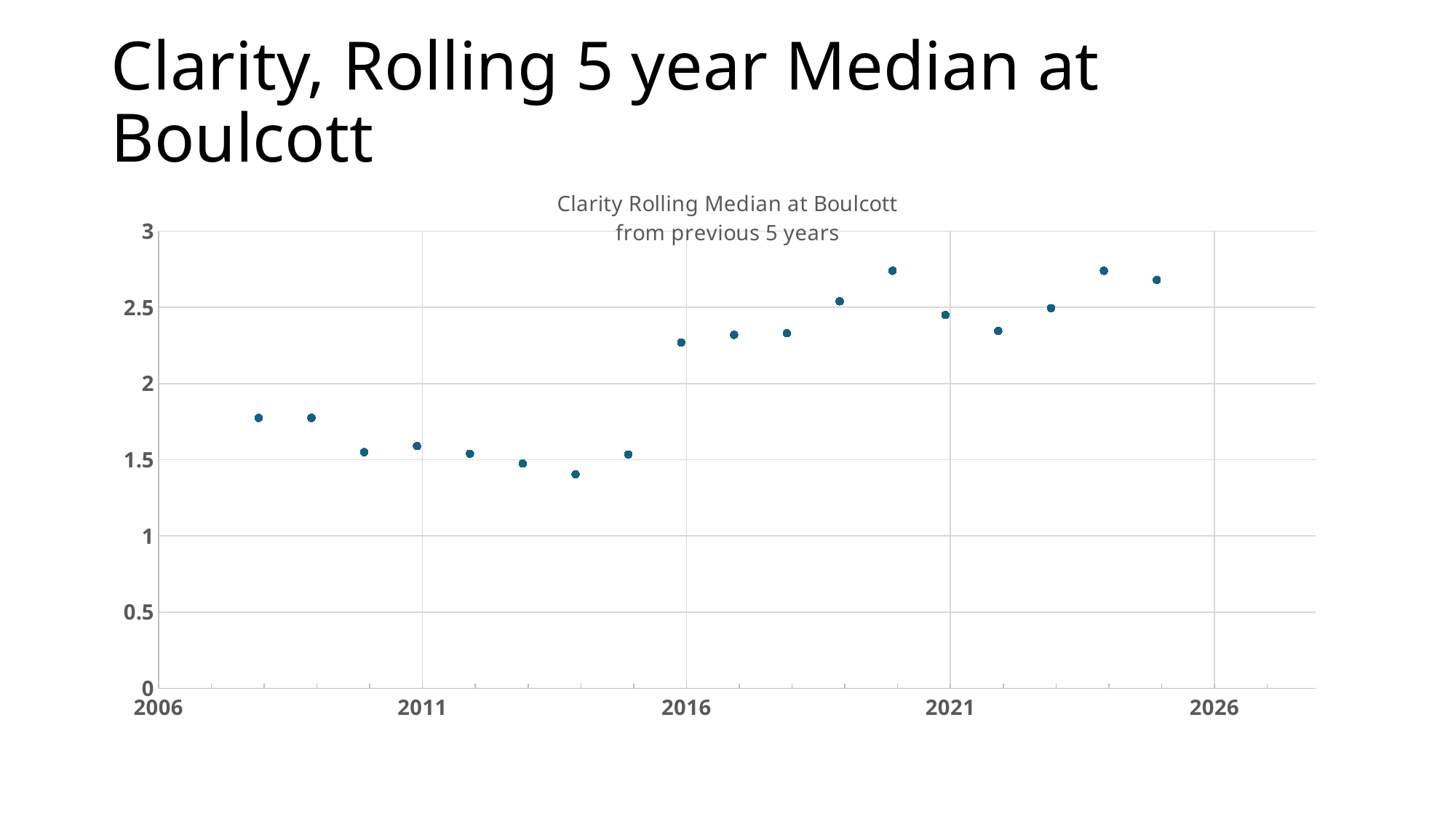
Is the rightmost plotted point greater or less than 2.5? greater What is the title printed above the chart's plot area? Clarity Rolling Median at Boulcott from previous 5 years Overall, from the leftmost point to the rightmost point, do the values rise or fall? rise Is the highest plotted point greater or less than 2.5? greater Is the leftmost plotted point greater or less than 2? less Between about 2008 and 2014, do the plotted values generally rise or fall? fall Comparing the points before 2016 with those after 2016, are the later values higher or lower? higher What kind of chart is shown on the slide? scatter chart What is the highest value shown on the vertical axis? 3 Is the leftmost plotted point higher or lower than the rightmost plotted point? lower How many data points are plotted on the chart? 18